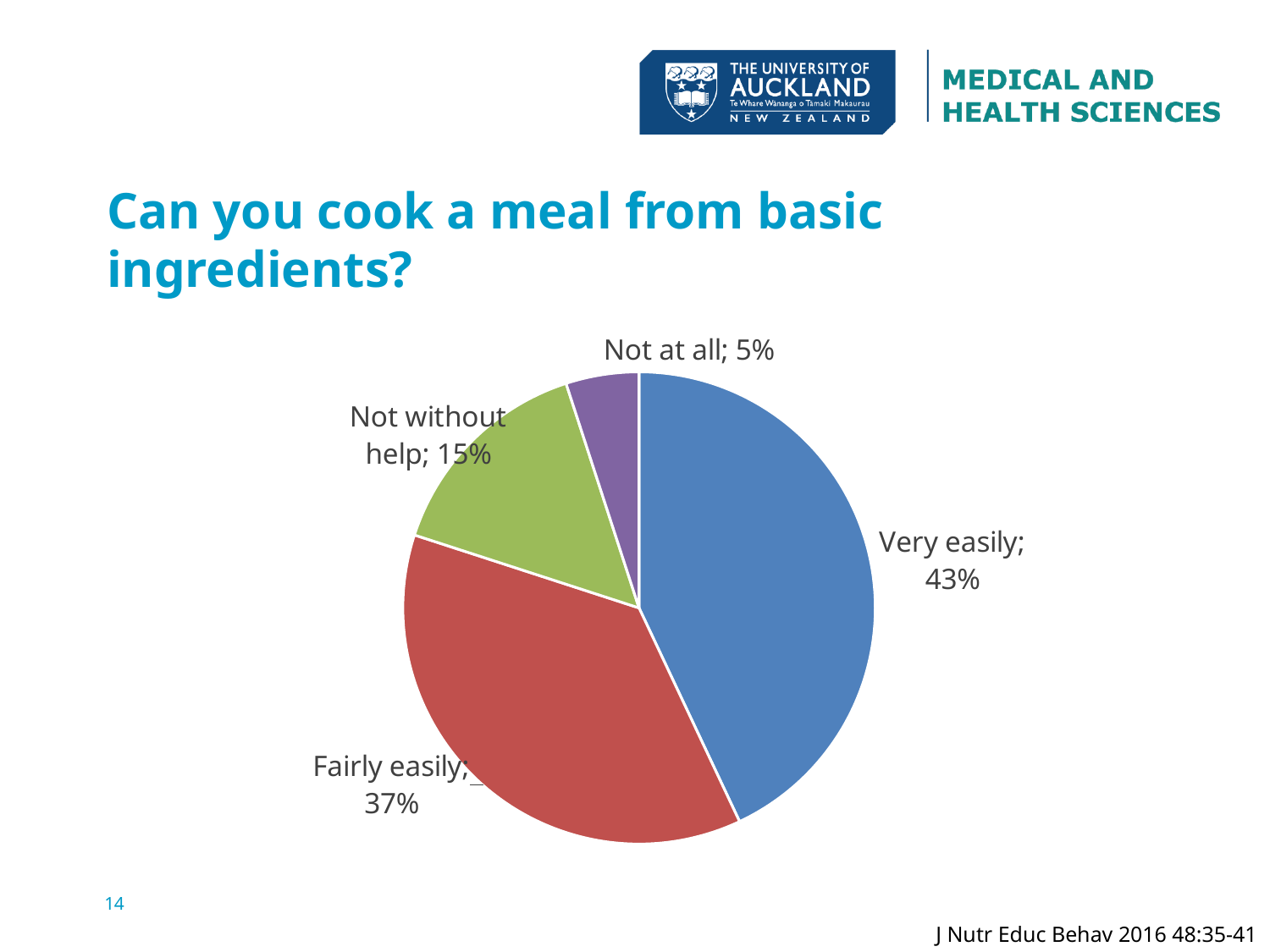
What percentage of respondents said they can cook a meal from basic ingredients 'Very easily'? 43% What percentage of respondents answered 'Fairly easily'? 37% What kind of chart is shown on the slide? Pie chart How many response categories are shown in the pie chart? 4 Which response category has the largest share of the pie? Very easily What colour is the 'Very easily' slice of the pie? Blue What is the difference in percentage points between 'Not without help' and 'Not at all'? 10 What percentage of respondents answered 'Not without help'? 15% What percentage of respondents answered 'Not at all'? 5% Which is larger, the share for 'Fairly easily' or the share for 'Not without help'? Fairly easily What is the difference in percentage points between 'Very easily' and 'Fairly easily'? 6 Which response category has the smallest share of the pie? Not at all